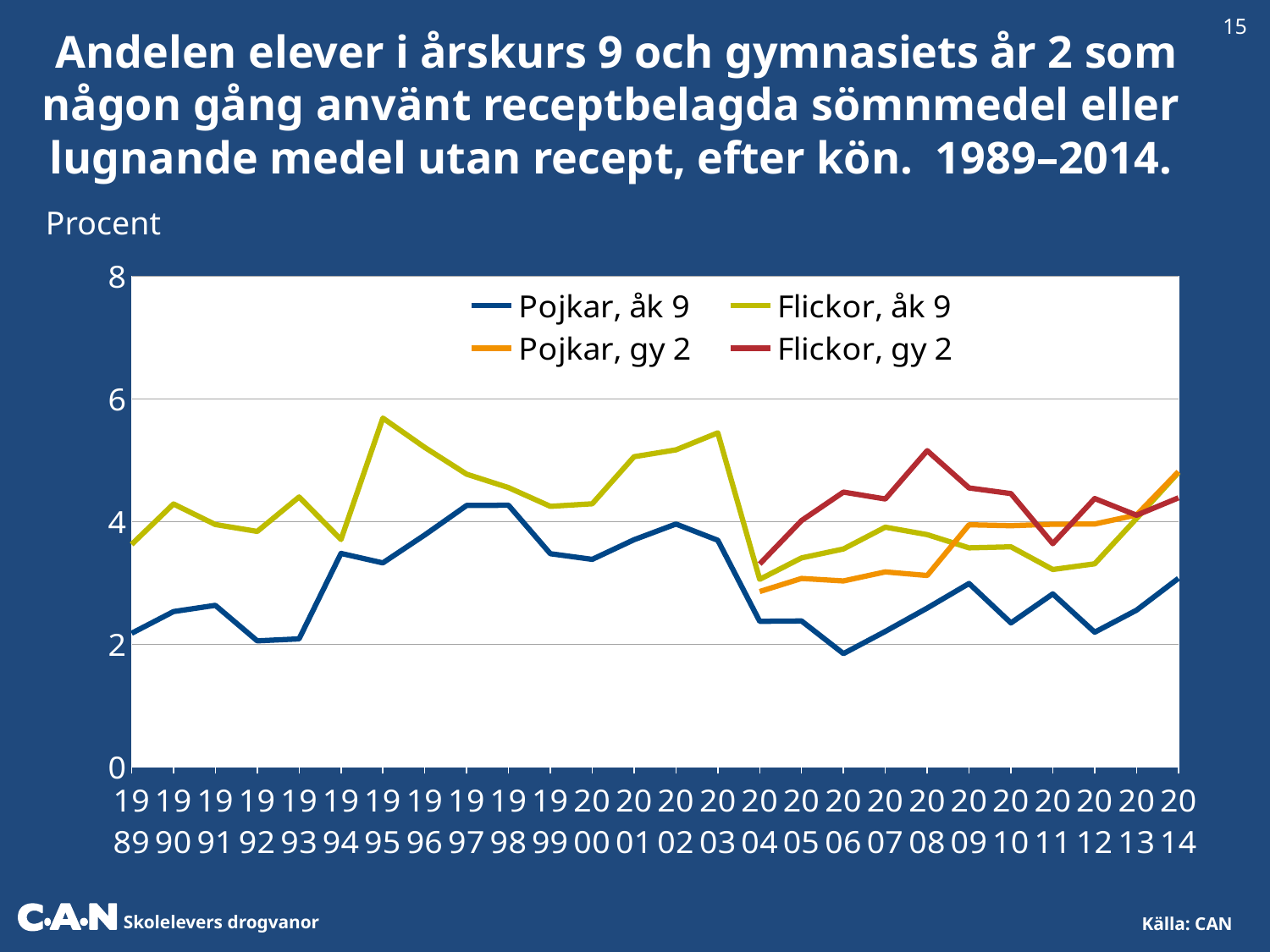
Is the value for Pojkar, åk 9 in 2006 greater or less than 2? less How many years are shown on the x axis? 26 How many series does the legend list? 4 Does the Flickor, åk 9 line rise or fall from 2003 to 2004? Fall What is the unit label shown above the chart? Procent In 2003, which is higher: Flickor, åk 9 or Pojkar, åk 9? Flickor, åk 9 Which series has the highest value in 1995? Flickor, åk 9 What kind of chart is shown on the slide? Line chart Which series has the lowest value in 2006? Pojkar, åk 9 Is the value for Pojkar, gy 2 in 2004 greater or less than 4? less Is the value for Flickor, gy 2 in 2008 greater or less than 4? greater